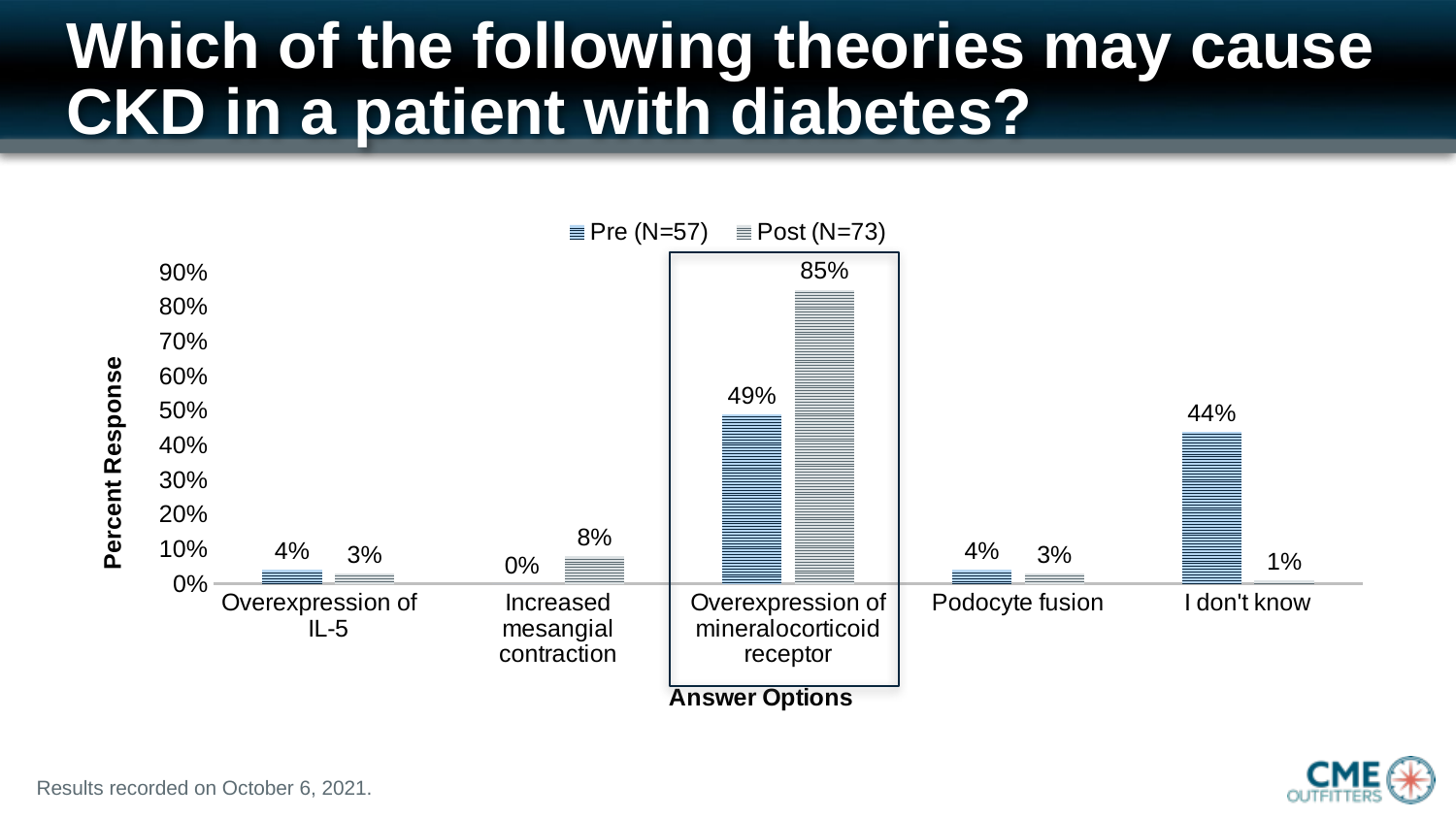
What is the Post (N=73) value for Overexpression of mineralocorticoid receptor? 85% What kind of chart is shown on the slide? Bar chart What is the difference between the Post and Pre values for Overexpression of mineralocorticoid receptor? 36% Which is larger for Podocyte fusion, the Pre (N=57) value or the Post (N=73) value? Pre (N=57) Which answer option has the lowest Post (N=73) value? I don't know What is the Pre (N=57) value for Increased mesangial contraction? 0% How many series does the legend list? 2 What is the label of the y axis? Percent Response What is the Pre (N=57) value for I don't know? 44% Which answer option has the highest Post (N=73) value? Overexpression of mineralocorticoid receptor What is the difference between the Pre and Post values for I don't know? 43% How many answer options are shown on the x axis? 5